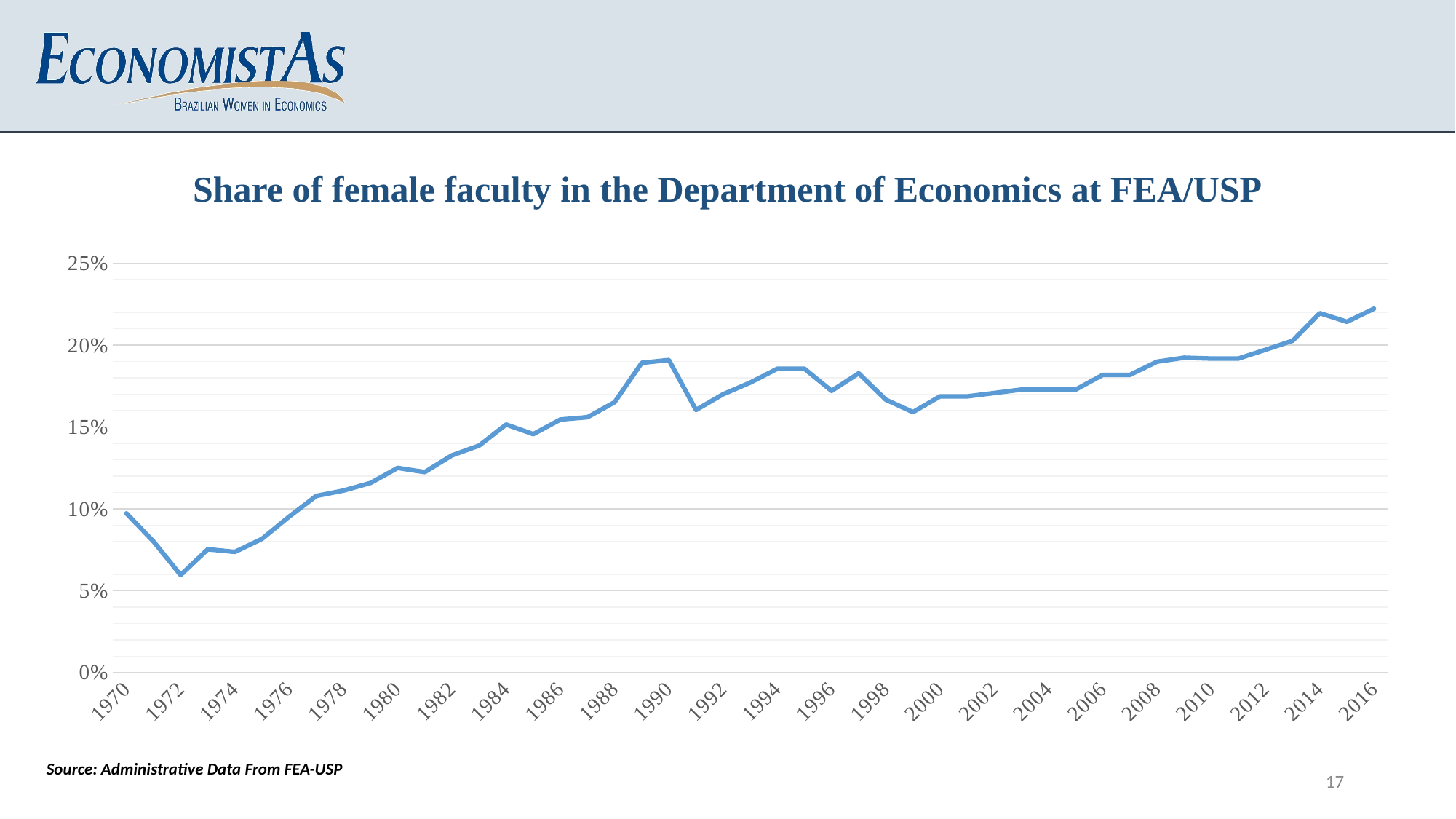
What kind of chart is shown on the slide? line chart Is the value for 1990 greater or less than 15%? greater Is the value for 2000 greater or less than 20%? less What is the title of the chart? Share of female faculty in the Department of Economics at FEA/USP In which year is the share of female faculty lowest? 1972 Overall, does the share of female faculty rise or fall from 1970 to 2016? rise Is the value for 1972 greater or less than 10%? less Which year has a higher share of female faculty, 1990 or 1991? 1990 What source is cited below the chart? Administrative Data From FEA-USP Which year has a higher share of female faculty, 1970 or 2016? 2016